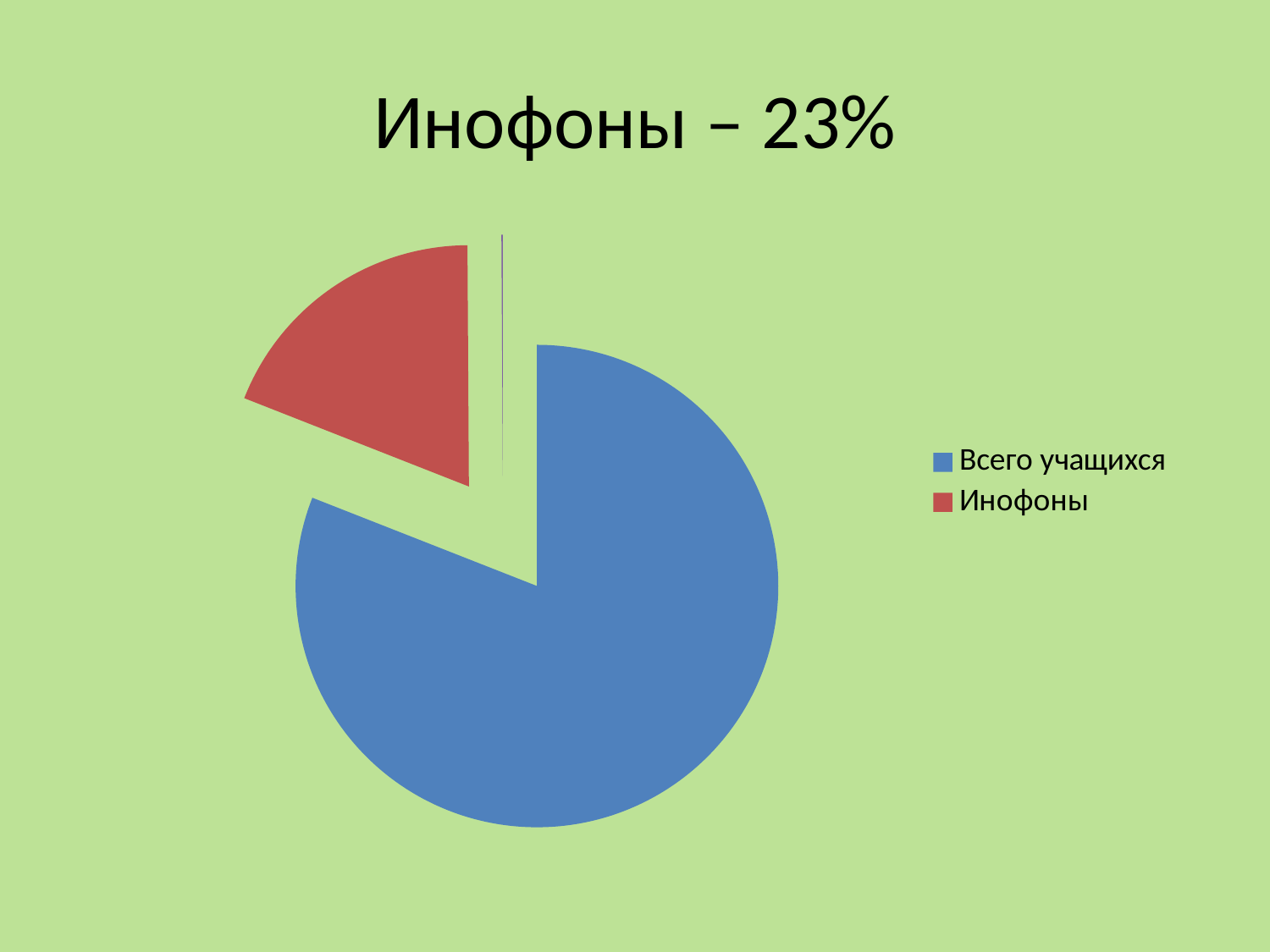
How many entries does the legend of the pie chart list? 2 Which slice of the pie chart is the largest? Всего учащихся Which is larger in the pie chart, the slice for Всего учащихся or the slice for Инофоны? Всего учащихся What colour is the slice for Инофоны in the pie chart? red According to the slide title, what share of the pie does Инофоны represent? 23% What is the title of the slide with the pie chart? Инофоны – 23% Which slice of the pie chart is the smallest? Инофоны What kind of chart is shown on the slide? pie chart